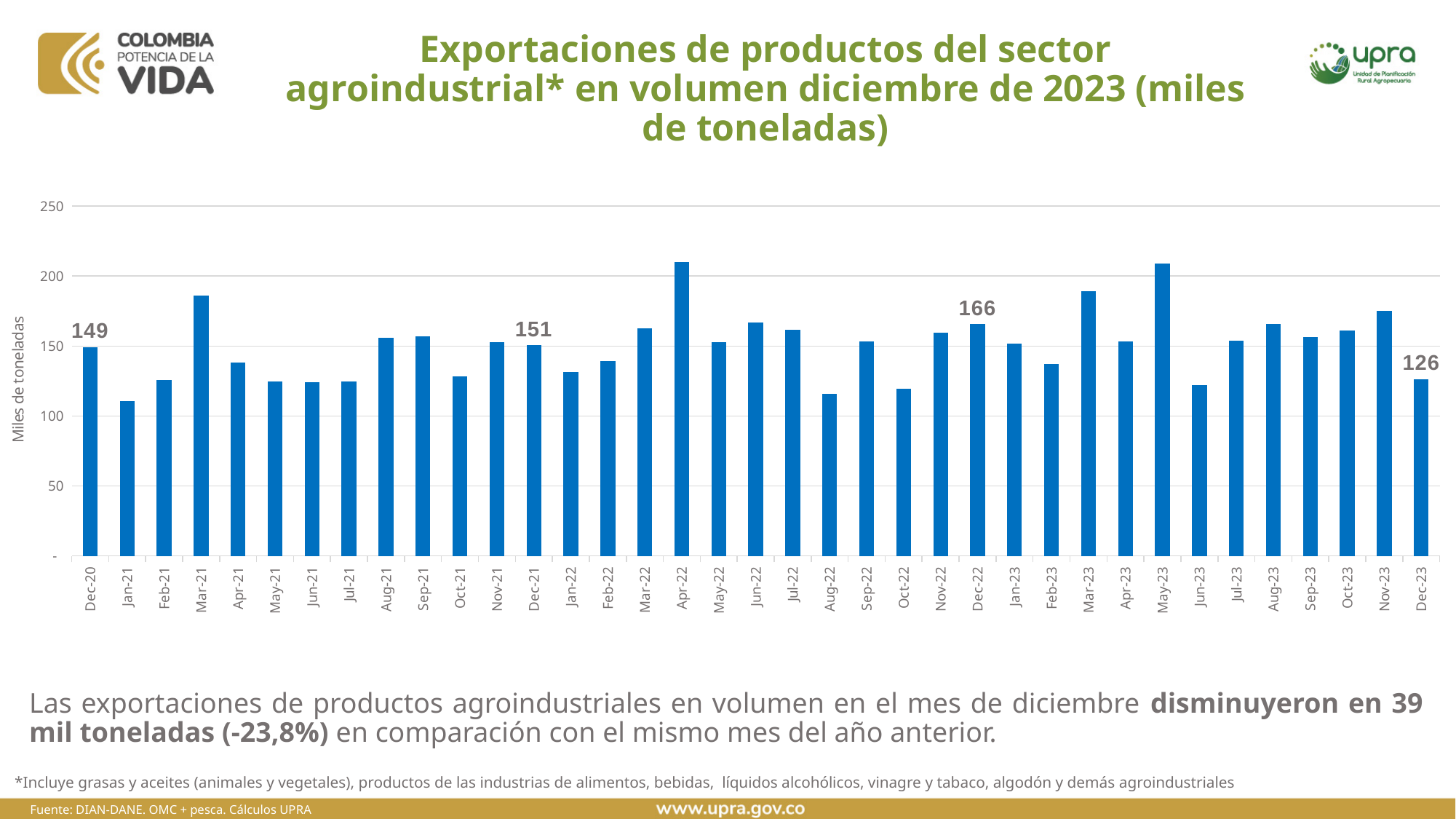
What is the value for Dec-22? 166 Is the value for Aug-22 greater or less than 150? less What kind of chart is shown on the slide? bar chart Is the value for Mar-21 greater or less than 150? greater What is the label on the vertical axis of the chart? Miles de toneladas How many monthly bars are plotted in the chart? 37 What is the value for Dec-20? 149 Is the value for Apr-22 greater or less than 200? greater What is the value for Dec-21? 151 Which is larger, the value for Dec-20 or the value for Dec-23? Dec-20 What is the value for Dec-23? 126 What is the difference between the values for Dec-22 and Dec-23? 39